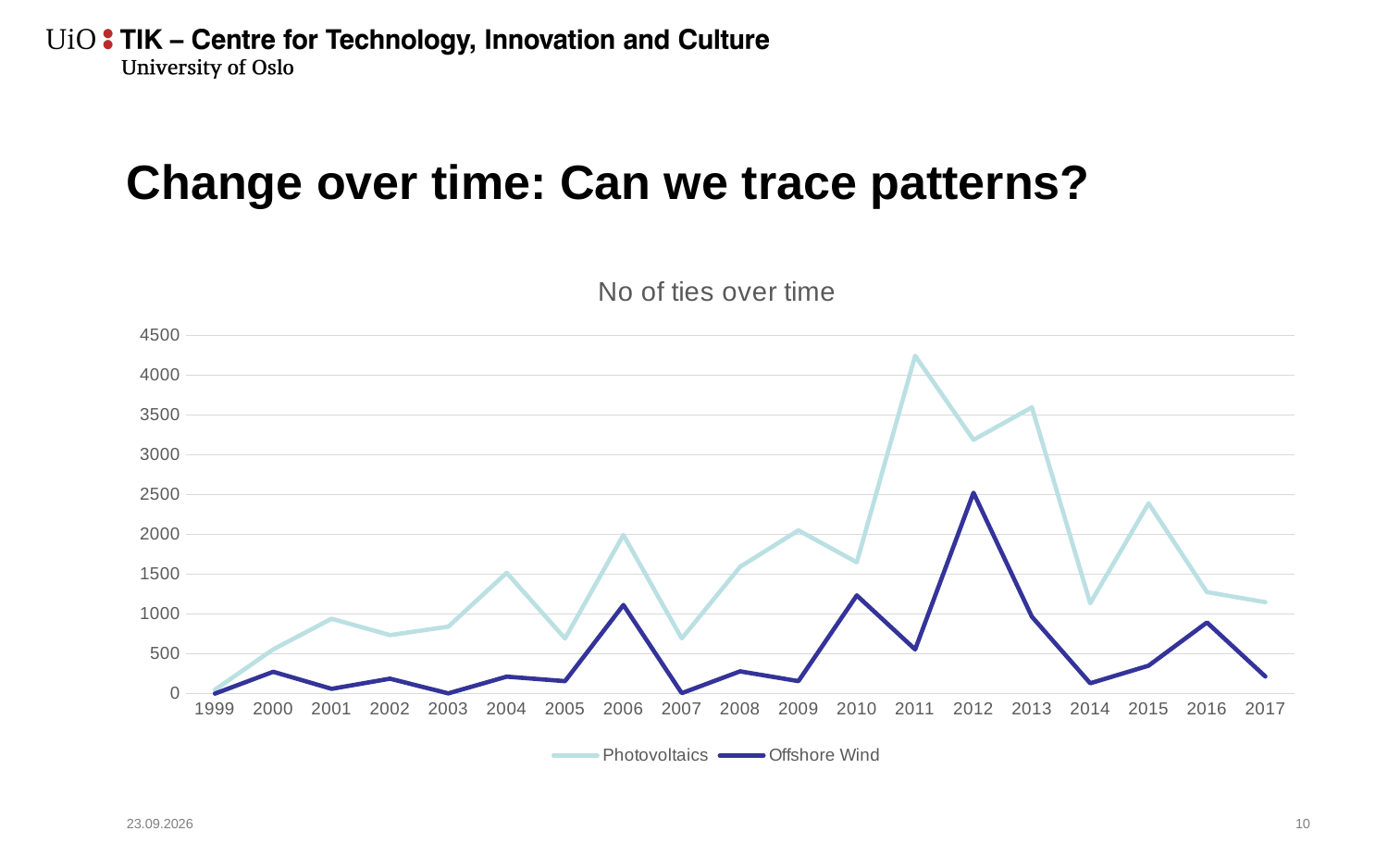
In which year does the Offshore Wind series reach its highest value? 2012 Is the value for Photovoltaics in 2014 greater or less than 1500? less What kind of chart is shown on the slide? line chart Is the value for Offshore Wind in 2012 greater or less than 2000? greater In which year is the Photovoltaics series at its lowest value? 1999 What is the title of the chart? No of ties over time How many series does the legend list? 2 Is the value for Photovoltaics in 2011 greater or less than 4000? greater In which year does the Photovoltaics series reach its highest value? 2011 In 2006, which series has the larger value, Photovoltaics or Offshore Wind? Photovoltaics How many years are plotted along the x axis? 19